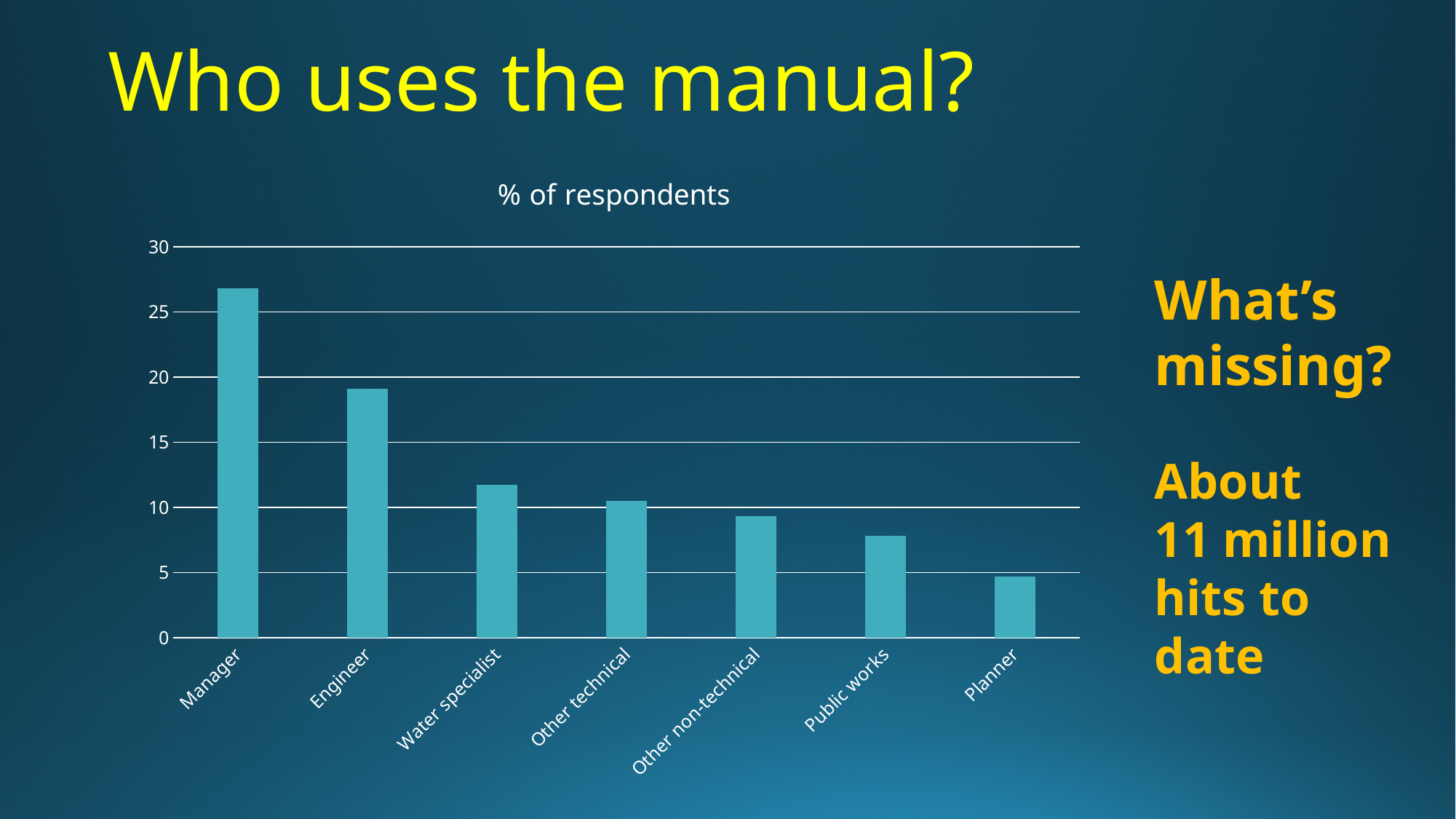
Which category has the highest value in the chart? Manager How many categories are shown on the x axis of the chart? 7 Is the value for Public works greater or less than 10? less Is the value for Engineer greater or less than 20? less Is the value for Water specialist greater or less than 10? greater Do the values rise or fall from left to right along the x axis? Fall What kind of chart is shown on the slide? Bar chart Which is larger, the value for Manager or the value for Engineer? Manager Which is larger, the value for Water specialist or the value for Public works? Water specialist What is the title of the chart? % of respondents Which category has the lowest value in the chart? Planner